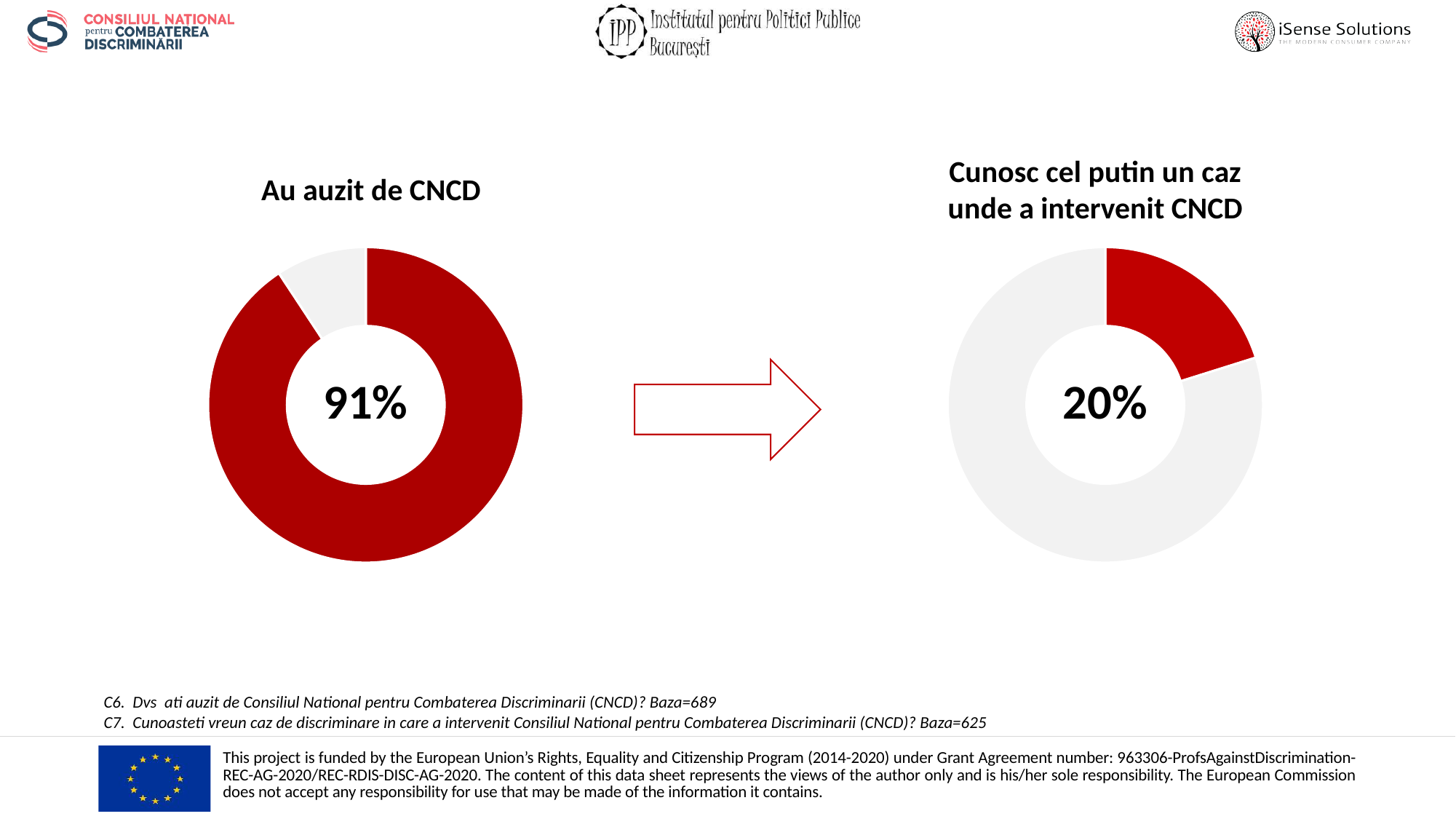
What kind of chart is used on the left of the slide, under the title "Au auzit de CNCD"? Donut (pie) chart Which of the two charts shows the higher percentage, "Au auzit de CNCD" or "Cunosc cel putin un caz unde a intervenit CNCD"? Au auzit de CNCD In the chart titled "Cunosc cel putin un caz unde a intervenit CNCD", which slice is larger, the red one or the grey one? The grey one How many donut charts are shown on the slide? 2 In the chart titled "Cunosc cel putin un caz unde a intervenit CNCD", is the red slice greater or less than half of the donut? less What is the title of the chart on the right side of the slide? Cunosc cel putin un caz unde a intervenit CNCD What is the difference in percentage points between the value in the "Au auzit de CNCD" chart and the value in the "Cunosc cel putin un caz unde a intervenit CNCD" chart? 71 percentage points How many slices does each donut chart on the slide have? 2 In the chart titled "Cunosc cel putin un caz unde a intervenit CNCD", what percentage is shown in the centre of the donut? 20% In the chart titled "Au auzit de CNCD", is the red slice greater or less than half of the donut? greater In the chart titled "Au auzit de CNCD", what percentage is shown in the centre of the donut? 91% What colour is used for the highlighted (value) slice in both donut charts? Red